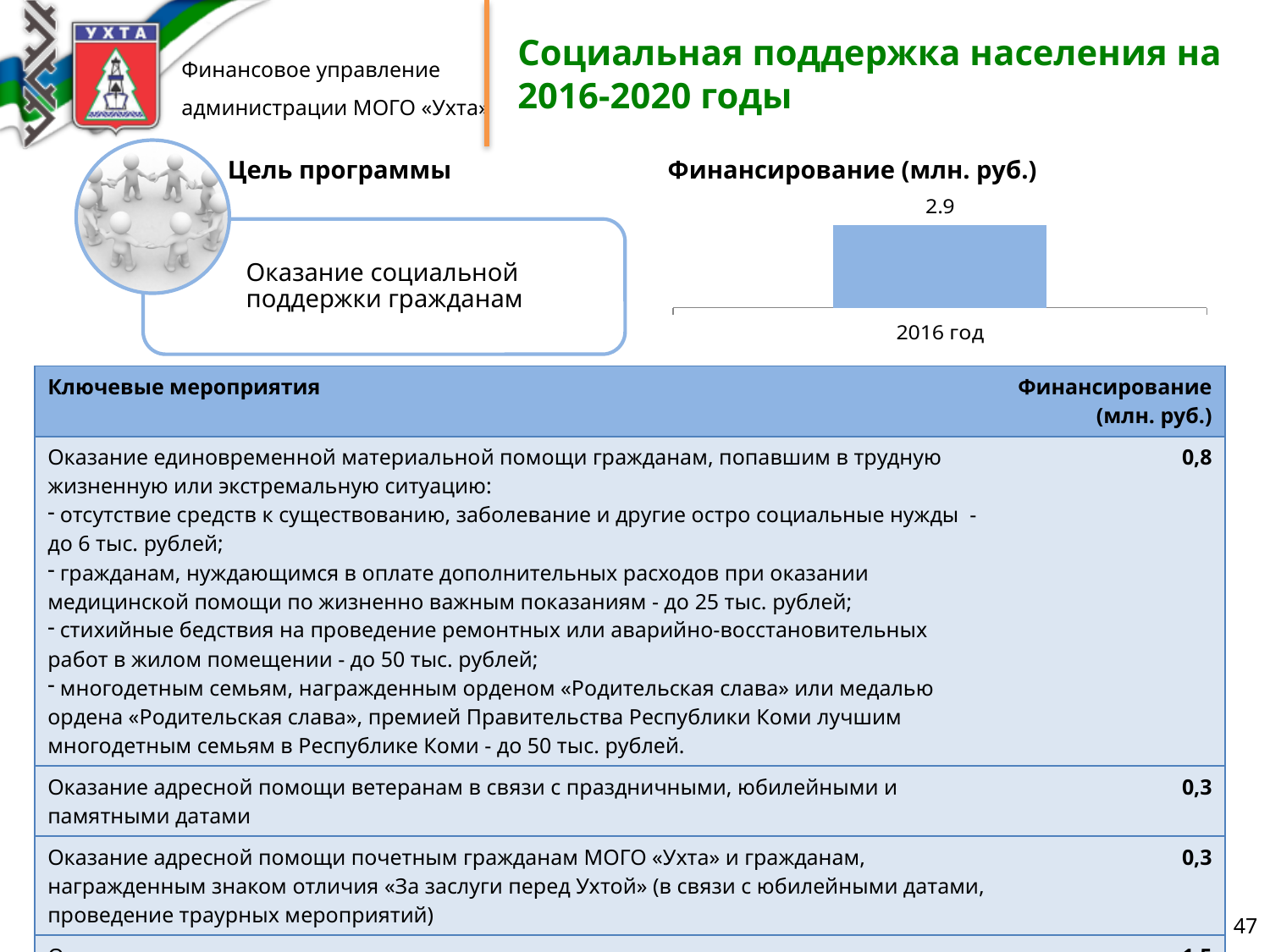
What kind of chart is used to show Финансирование (млн. руб.)? bar chart What is the title of the chart on the slide? Финансирование (млн. руб.) What is the value shown for 2016 год in the Финансирование (млн. руб.) chart? 2.9 How many bars does the Финансирование (млн. руб.) chart show? 1 Which category is labelled on the x axis of the Финансирование (млн. руб.) chart? 2016 год